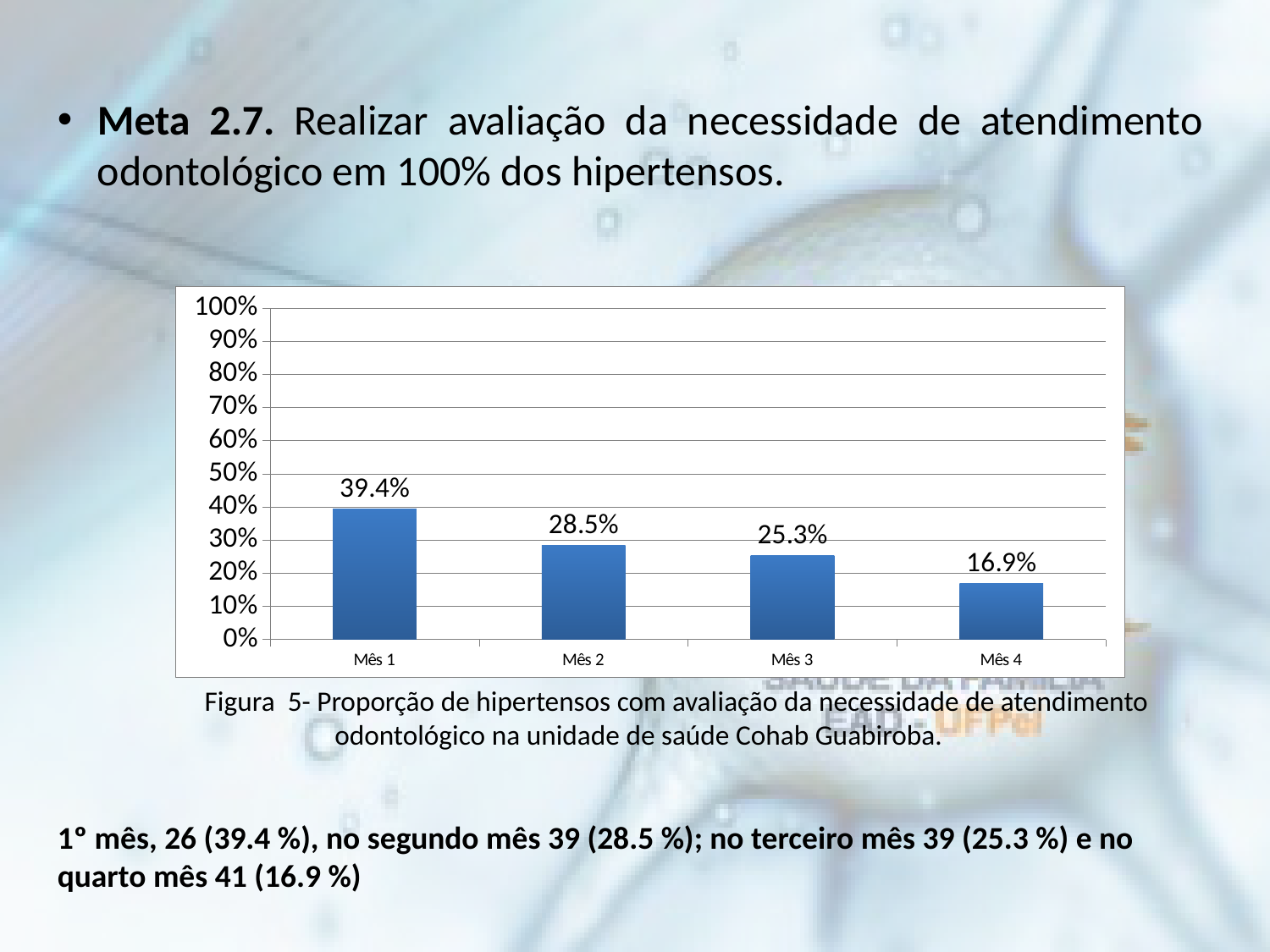
How many months are shown on the x axis? 4 What is the difference between the values for Mês 1 and Mês 2? 10.9% Which month has the lowest value? Mês 4 Is the value for Mês 1 greater or less than 50%? less What is the value for Mês 4? 16.9% Which is larger, the value for Mês 2 or the value for Mês 3? Mês 2 Do the values rise or fall from Mês 1 to Mês 4? fall What is the difference between the values for Mês 3 and Mês 4? 8.4% What kind of chart is shown? bar chart What is the value for Mês 1? 39.4% What is the value for Mês 3? 25.3% Which month has the highest value? Mês 1